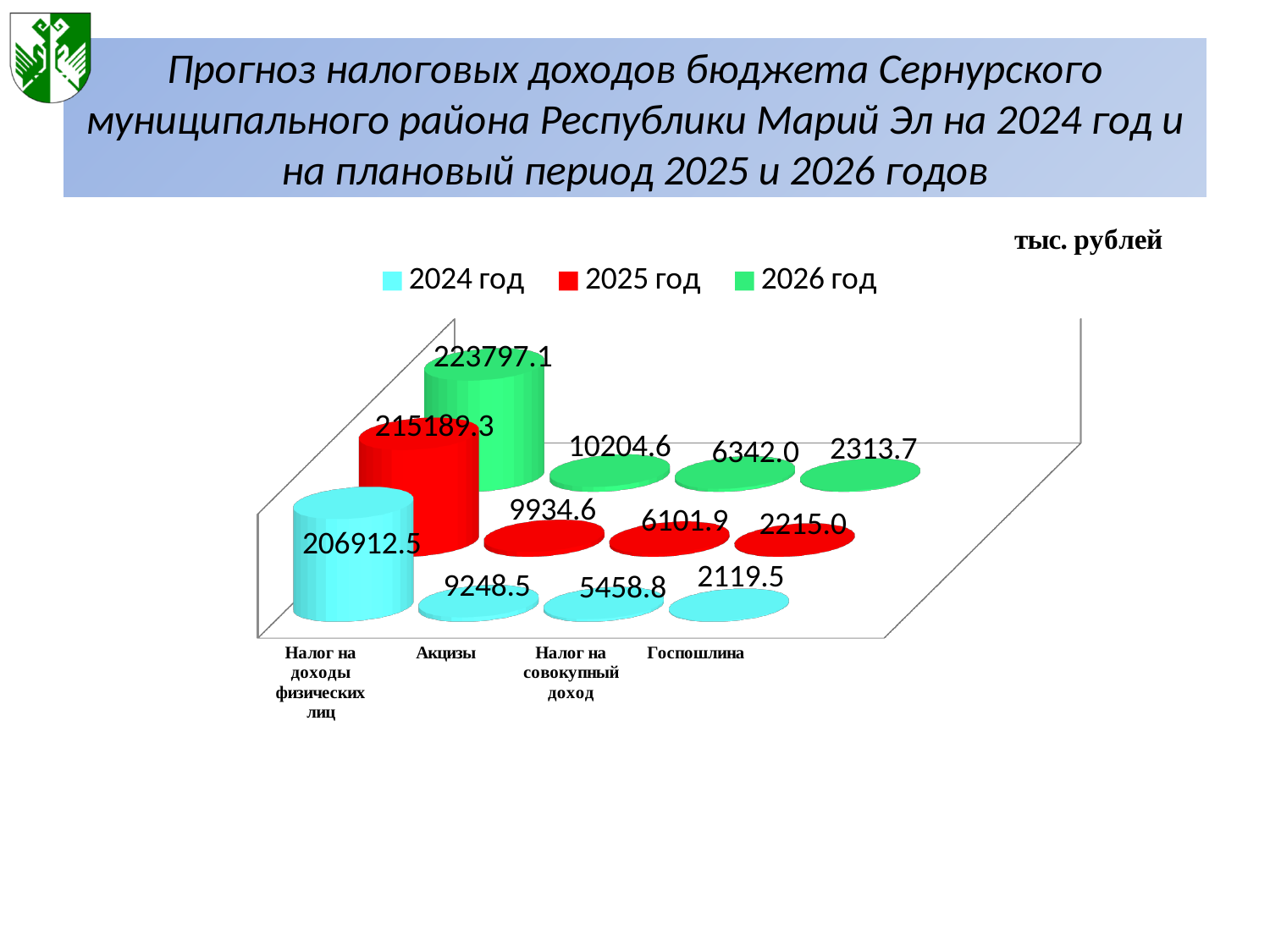
What is the difference between the 2026 год and 2024 год values for Налог на доходы физических лиц? 16884.6 Which category has the highest value in the 2026 год series? Налог на доходы физических лиц What is the 2025 год value for Налог на совокупный доход? 6101.9 How many series does the legend list? 3 What is the 2026 год value for Акцизы? 10204.6 Which category has the lowest value in the 2024 год series? Госпошлина Which is larger for Акцизы: the 2025 год value or the 2024 год value? 2025 год How many categories are shown on the x axis? 4 What is the 2025 год value for Госпошлина? 2215.0 What unit is stated for the values in the chart? тыс. рублей What is the difference between the 2026 год and 2024 год values for Госпошлина? 194.2 What is the 2024 год value for Налог на доходы физических лиц? 206912.5